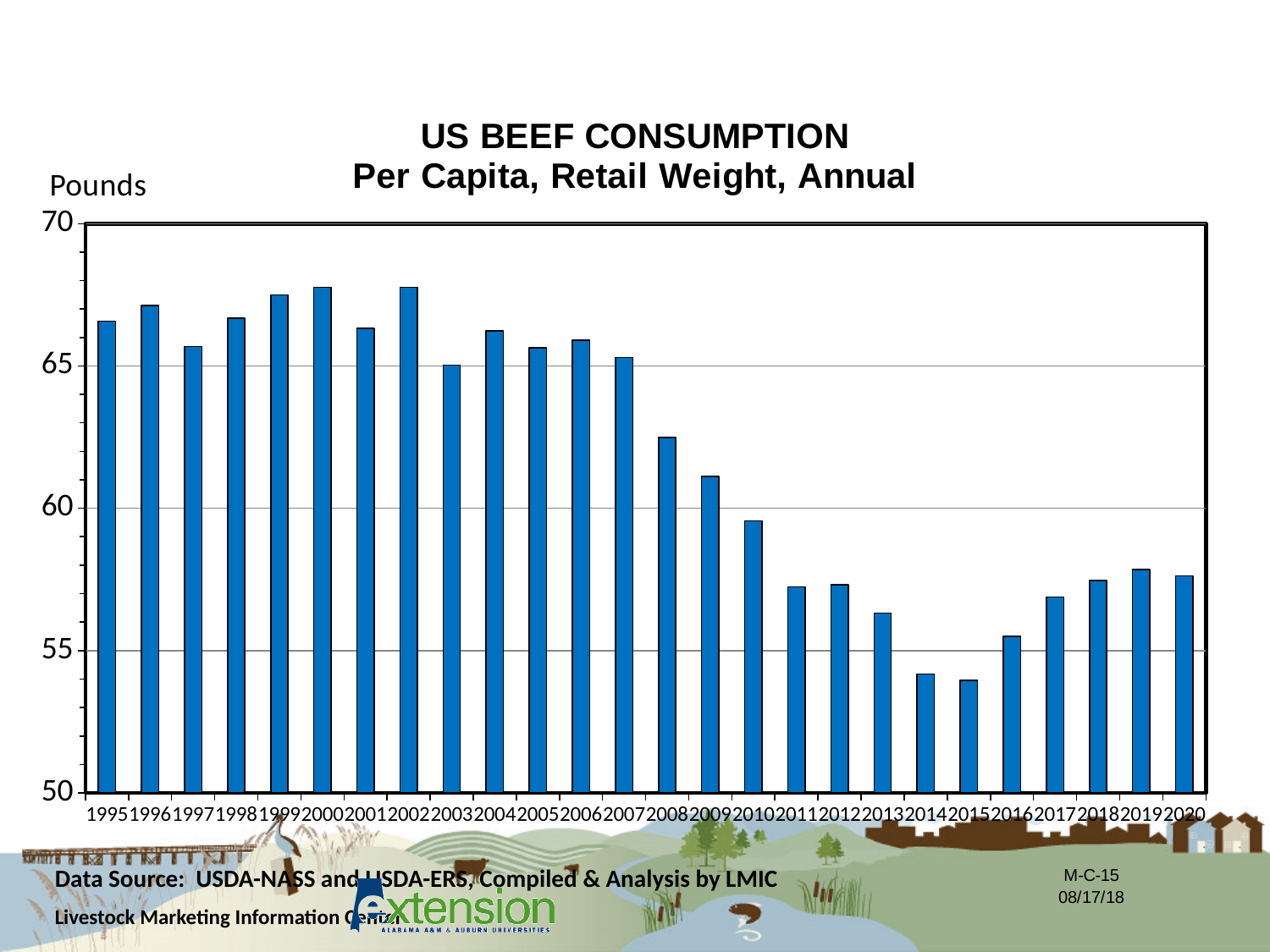
What kind of chart is shown on the slide? bar chart Do the values rise or fall from 2007 to 2015? fall What is the title of the chart? US BEEF CONSUMPTION Per Capita, Retail Weight, Annual How many years are plotted on the chart? 26 Is the value for 2019 greater or less than 60? less What unit is shown on the vertical axis? Pounds Which year has the larger value, 2003 or 2010? 2003 Is the value for 1999 greater or less than 65? greater Which year has the larger value, 2008 or 2011? 2008 Is the value for 2015 greater or less than 55? less